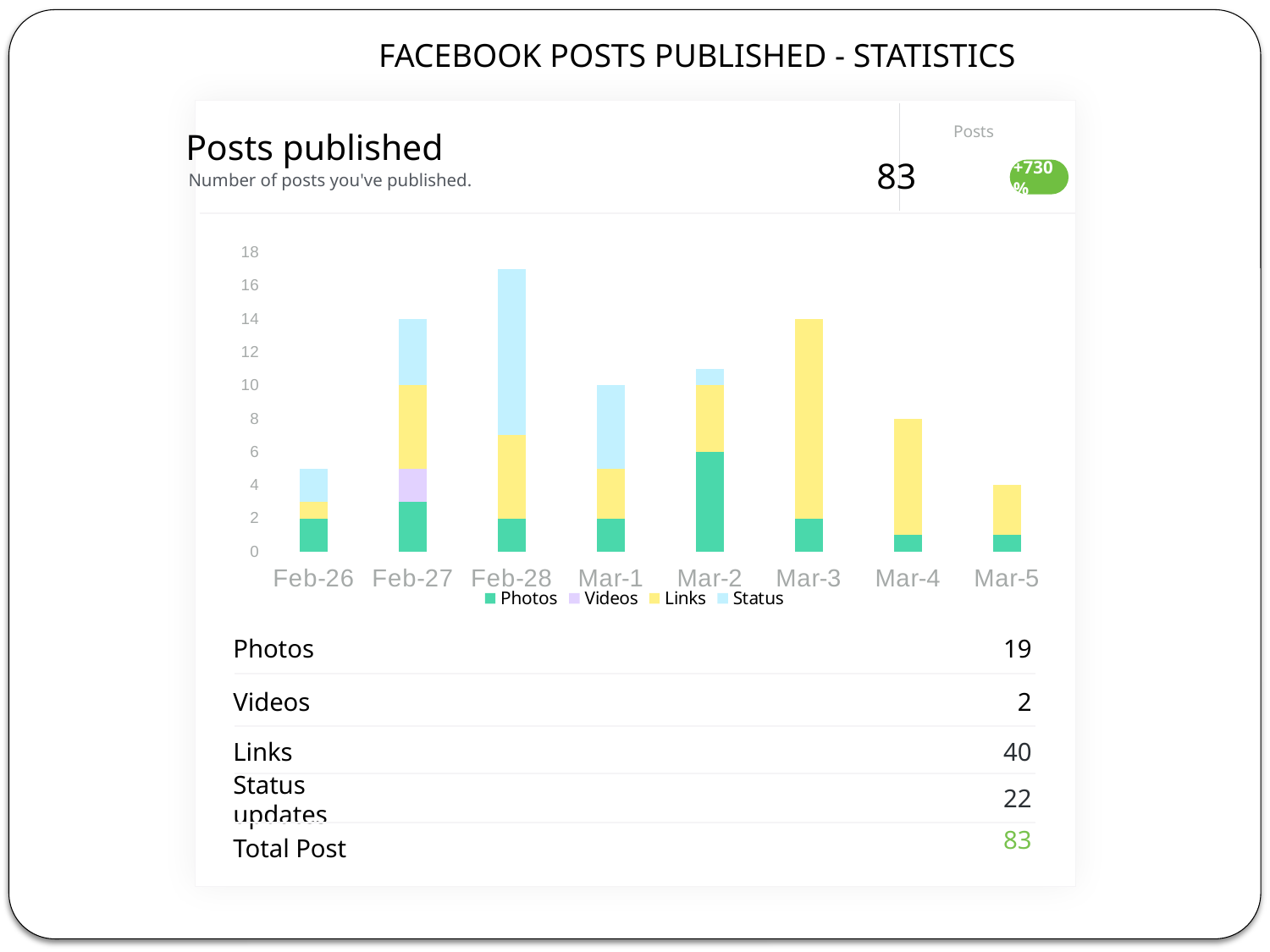
What is the total height of the stacked bar for Mar-3? 14 Is the total for Feb-28 greater or less than 16? greater What is the total height of the stacked bar for Mar-4? 8 Is the total for Feb-26 greater or less than 6? less What kind of chart is shown on the slide? bar chart Which stacked bar is taller, Mar-3 or Mar-4? Mar-3 What is the difference between the stacked bar totals for Mar-3 and Mar-4? 6 How many series does the chart legend list? 4 What is the Photos value for Mar-2? 6 Which date has the tallest stacked bar? Feb-28 How many dates are shown along the x axis of the chart? 8 What are the four series listed in the chart legend? Photos, Videos, Links, Status